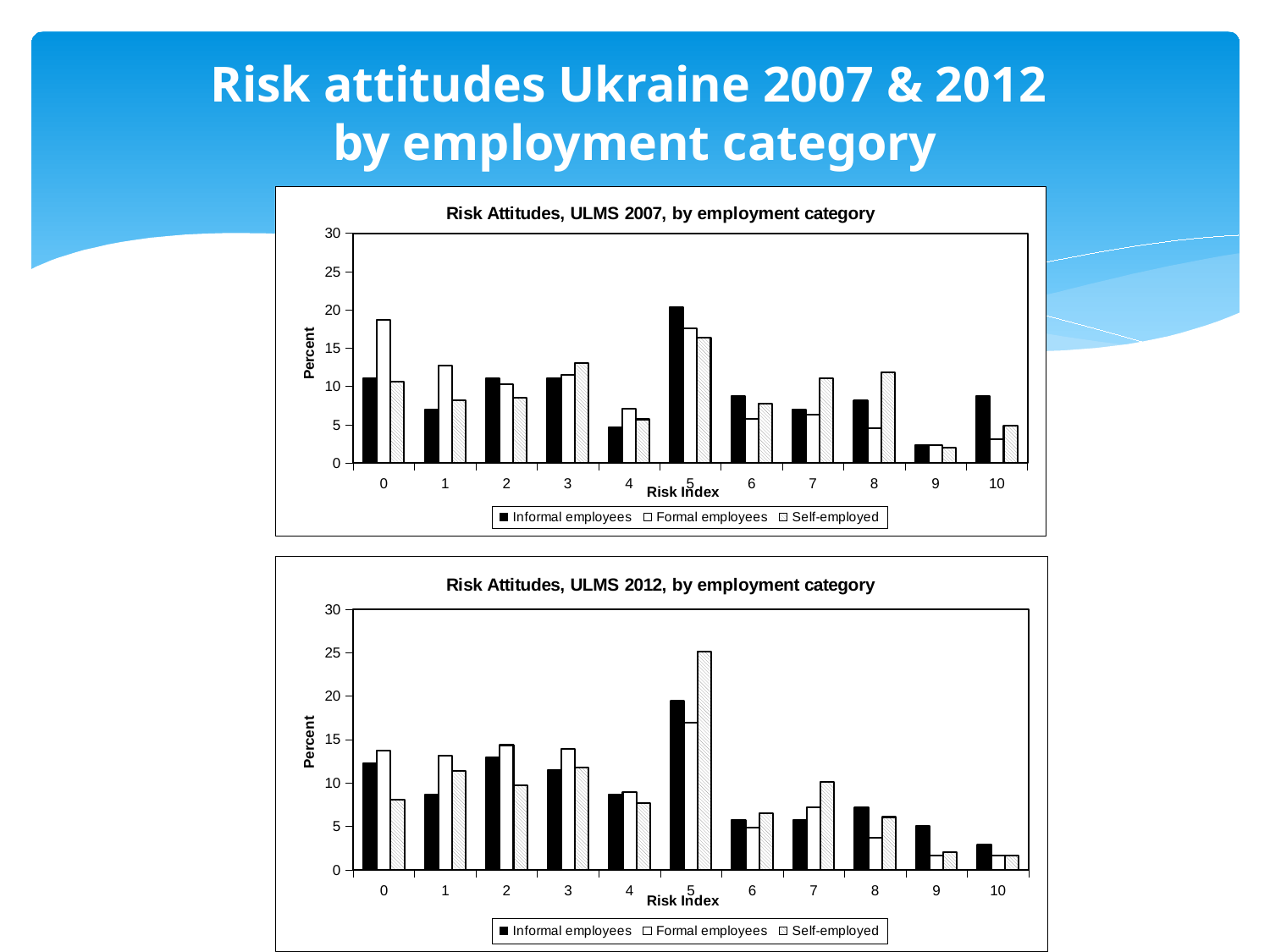
In the 'Risk Attitudes, ULMS 2012, by employment category' chart, at risk index 0, which is larger: Formal employees or Self-employed? Formal employees What kind of chart is the 'Risk Attitudes, ULMS 2007, by employment category' chart? bar chart In the 'Risk Attitudes, ULMS 2007, by employment category' chart, at risk index 8, which is larger: Formal employees or Self-employed? Self-employed What is the label of the y axis on the 'Risk Attitudes, ULMS 2012, by employment category' chart? Percent In the 'Risk Attitudes, ULMS 2012, by employment category' chart, is the Self-employed value at risk index 5 greater or less than 20? greater How many risk index categories are shown on the x axis of the 'Risk Attitudes, ULMS 2007, by employment category' chart? 11 In the 'Risk Attitudes, ULMS 2012, by employment category' chart, at which risk index is the Self-employed bar highest? 5 In the 'Risk Attitudes, ULMS 2007, by employment category' chart, is the Informal employees value at risk index 9 greater or less than 5? less In the 'Risk Attitudes, ULMS 2007, by employment category' chart, at which risk index is the Informal employees bar highest? 5 In the 'Risk Attitudes, ULMS 2007, by employment category' chart, at which risk index is the Informal employees bar lowest? 9 In the 'Risk Attitudes, ULMS 2007, by employment category' chart, is the Formal employees value at risk index 0 greater or less than 15? greater How many series does the legend of the 'Risk Attitudes, ULMS 2012, by employment category' chart list? 3